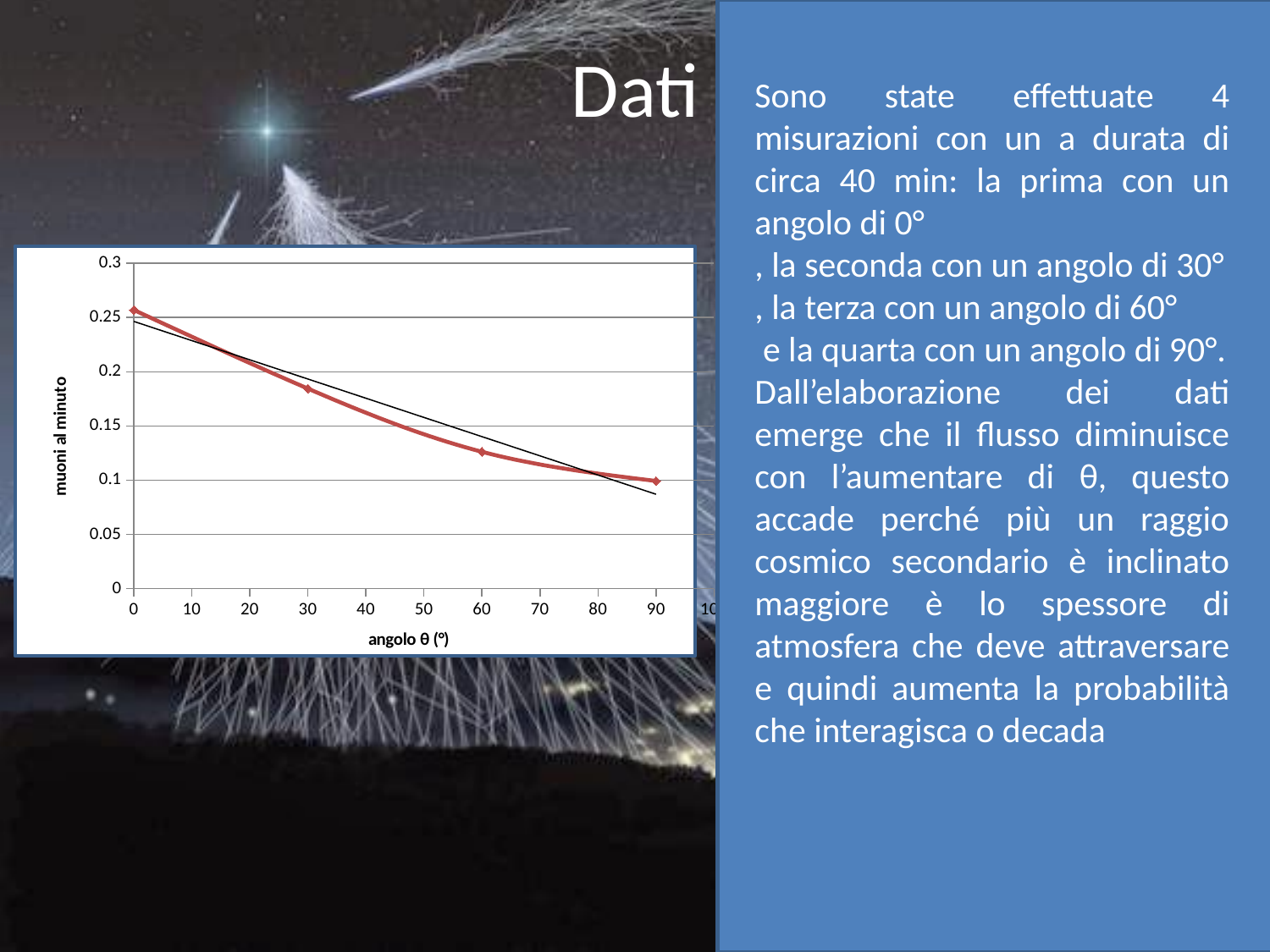
What kind of chart is shown on the slide? line chart Do the values of muoni al minuto rise or fall as the angle θ increases? fall Is the value of muoni al minuto at angle 30 greater or less than 0.2? less How many data points are plotted on the red curve? 4 Which has the larger value of muoni al minuto, angle 30 or angle 60? angle 30 Is the value of muoni al minuto at angle 60 greater or less than 0.15? less What is the title of the y axis of the chart? muoni al minuto Is the value of muoni al minuto at angle 90 greater or less than 0.15? less What is the title of the x axis of the chart? angolo θ (°) At which angle θ is the value of muoni al minuto highest? 0 At which angle θ is the value of muoni al minuto lowest? 90